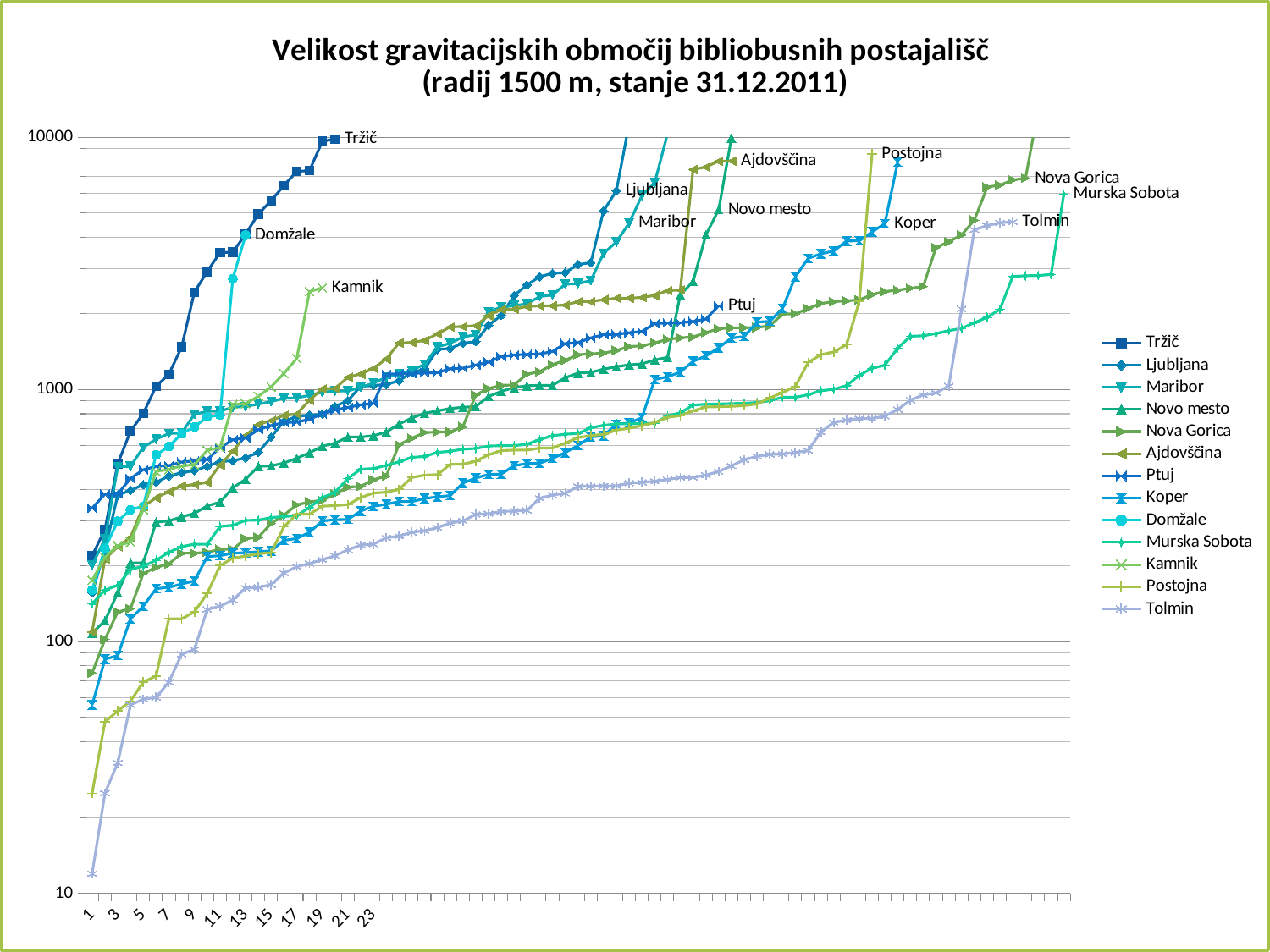
Is the last value for Kamnik greater or less than 1000? greater How many series does the legend list? 13 What kind of chart is shown on the slide? line chart Is the first value for Koper greater or less than 100? less Do the values for Tržič rise or fall along the x axis? rise Which series has the lowest value at its first point? Tolmin Is the first value for Tolmin greater or less than 100? less Which series is marked with square markers in the legend? Tržič Do the values for Tolmin rise or fall along the x axis? rise What is the title of the chart? Velikost gravitacijskih območij bibliobusnih postajališč (radij 1500 m, stanje 31.12.2011)